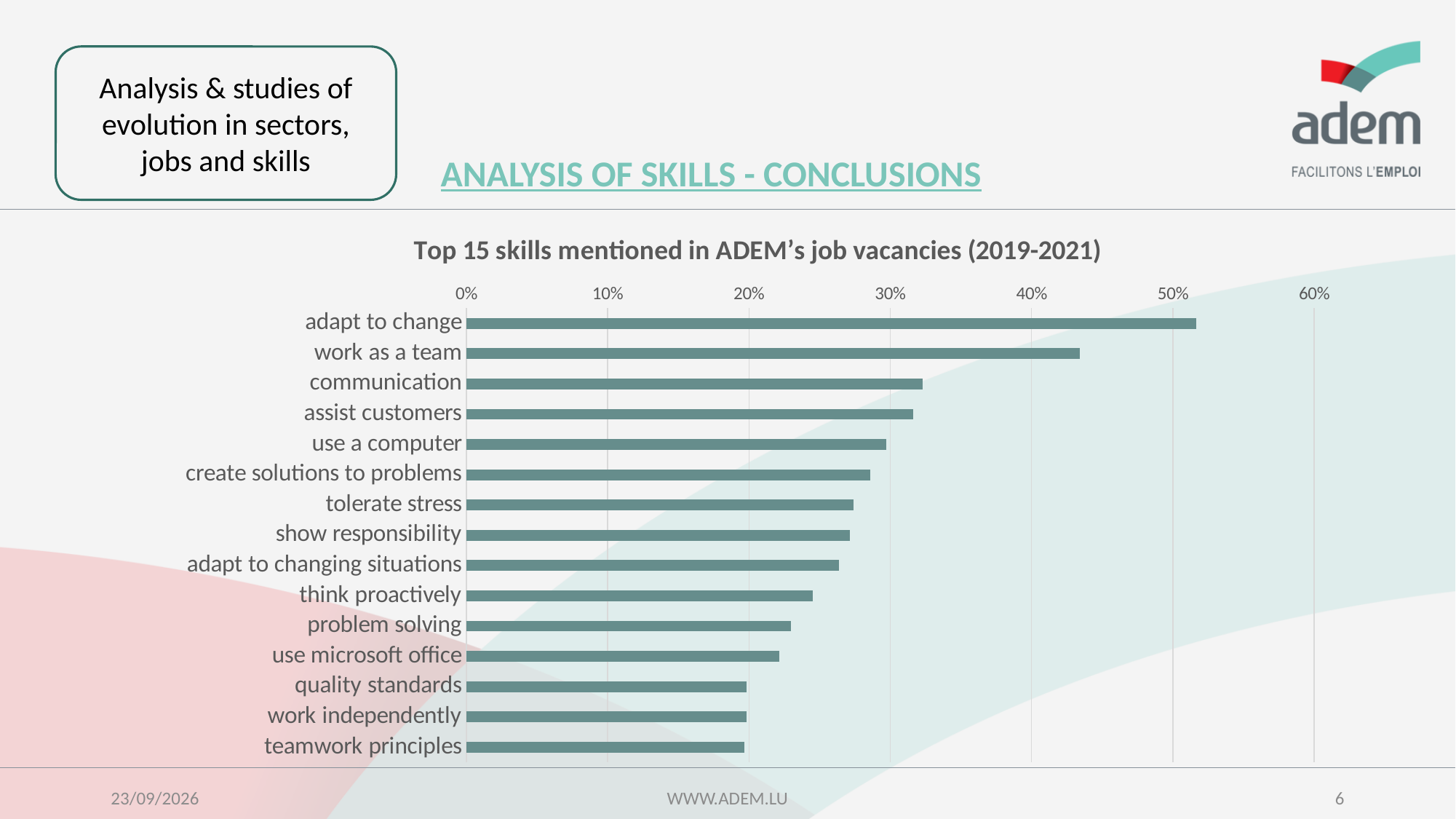
Is the value for 'use microsoft office' greater or less than 20%? greater Is the value for 'adapt to change' greater or less than 50%? greater Which is larger, the value for 'communication' or the value for 'problem solving'? communication Is the value for 'communication' greater or less than 30%? greater Do the bar values rise or fall going from the top skill to the bottom skill? fall What kind of chart is shown on the slide? bar chart How many skills are listed in the chart? 15 Which skill has the highest share of mentions in ADEM's job vacancies? adapt to change What is the title of the chart? Top 15 skills mentioned in ADEM's job vacancies (2019-2021) Which is larger, the value for 'adapt to change' or the value for 'work as a team'? adapt to change